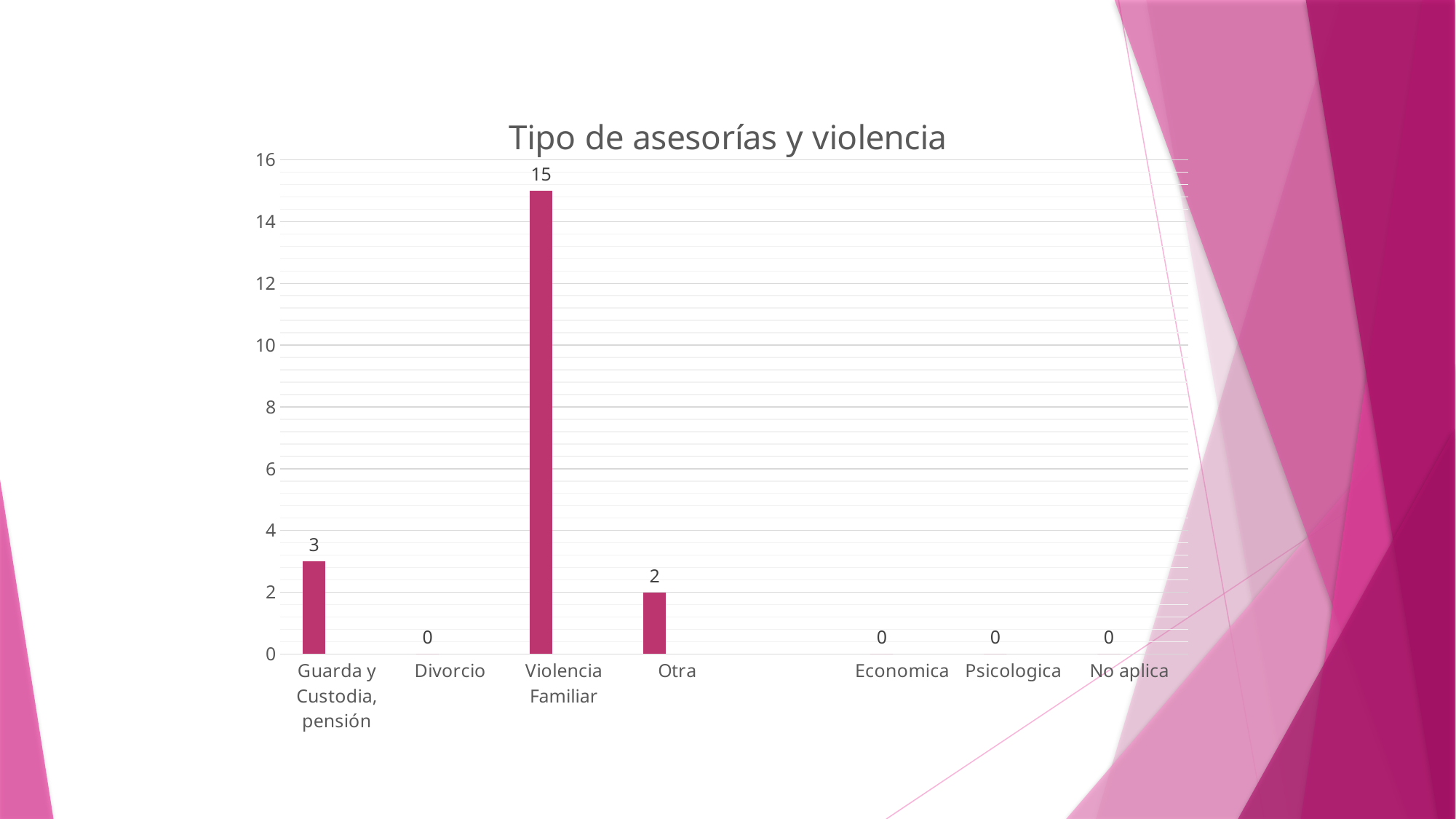
Which category has the highest value? Violencia Familiar Which is larger, the value for Guarda y Custodia, pensión or the value for Otra? Guarda y Custodia, pensión What is the title of the chart? Tipo de asesorías y violencia What is the value for Otra? 2 What is the value for Divorcio? 0 What is the difference between the values for Guarda y Custodia, pensión and Otra? 1 What is the difference between the values for Violencia Familiar and Guarda y Custodia, pensión? 12 What is the value for Violencia Familiar? 15 What is the value for Guarda y Custodia, pensión? 3 Is the value for Violencia Familiar greater or less than 10? greater What kind of chart is shown on the slide? Bar chart What is the value for Psicologica? 0